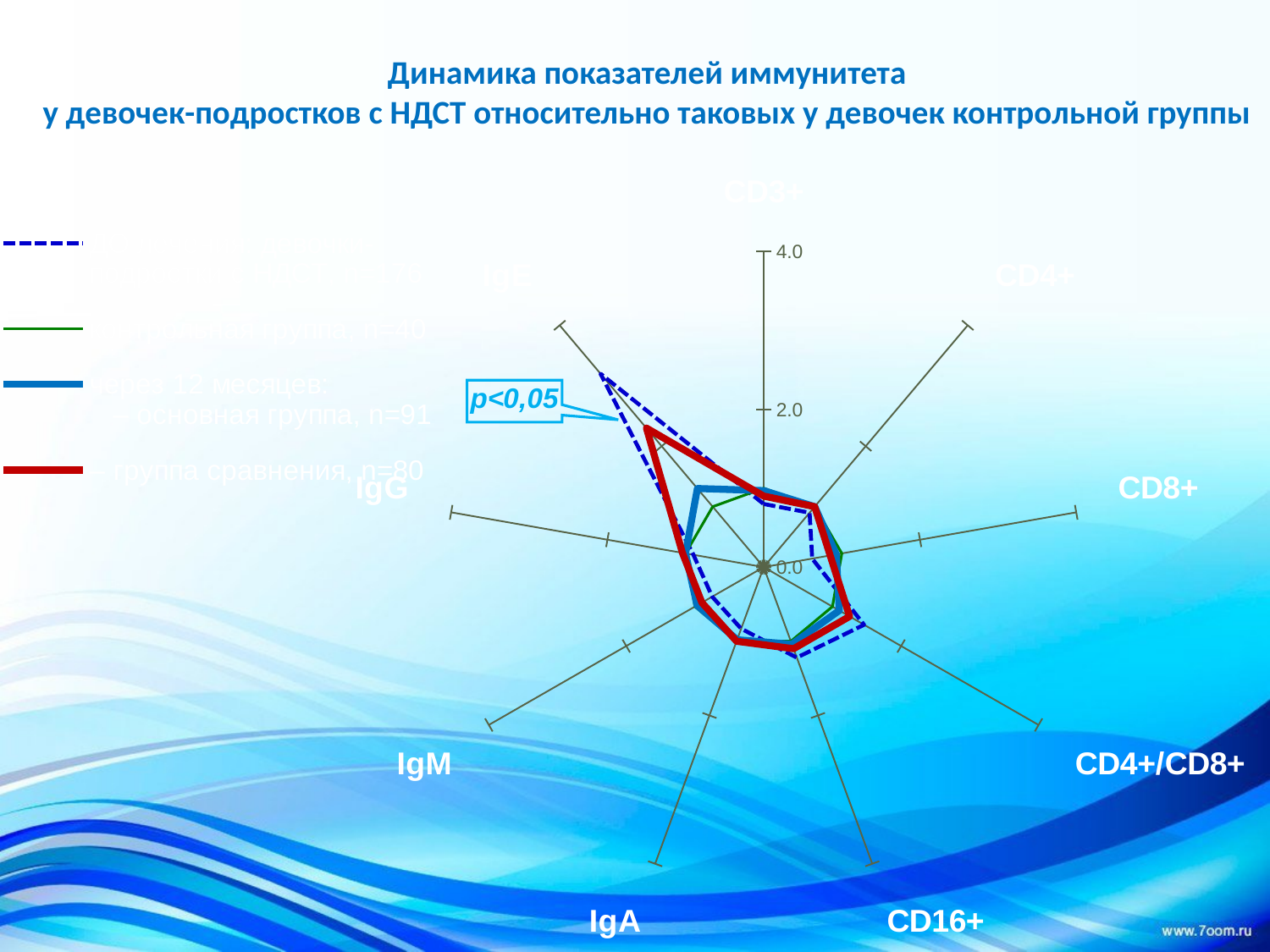
What is the highest value labelled on the radial axis of the chart? 4.0 On which axis does the dashed blue series reach its highest value? IgE How many axes (categories) does the radar chart have? 9 What significance annotation is placed next to the IgE spike of the chart? p<0,05 Is the value of the dashed blue series on the IgE axis greater or less than 2.0? greater On which axis does the red series reach its highest value? IgE Is the value of the red series on the CD8+ axis greater or less than 2.0? less Is the value of the dashed blue series on the CD4+/CD8+ axis greater or less than 2.0? less How many series does the legend list? 4 What kind of chart is shown on the slide? radar chart On the IgE axis, which series has the larger value: the dashed blue series or the solid blue series? the dashed blue series